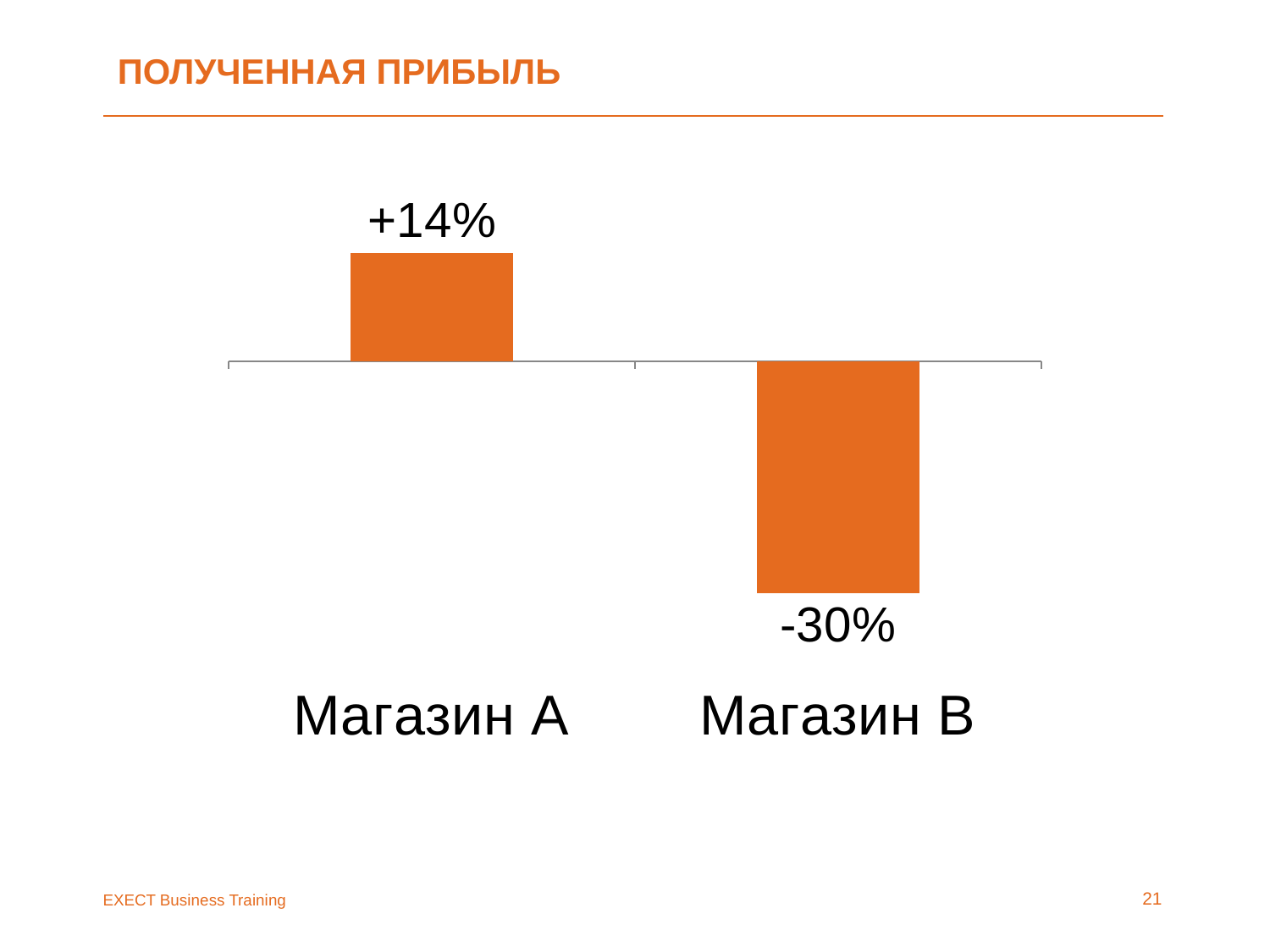
What is the value for Магазин В? -30% Do the values rise or fall from Магазин А to Магазин В? Fall Which category has the highest value? Магазин А Which category has the lowest value? Магазин В What is the value for Магазин А? +14% Which category has a negative value? Магазин В What kind of chart is shown on the slide? Bar chart What is the difference between the value for Магазин А and the value for Магазин В? 44 percentage points How many categories are shown in the chart? 2 Which is larger, the value for Магазин А or the value for Магазин В? Магазин А What is the title of the slide containing the chart? ПОЛУЧЕННАЯ ПРИБЫЛЬ